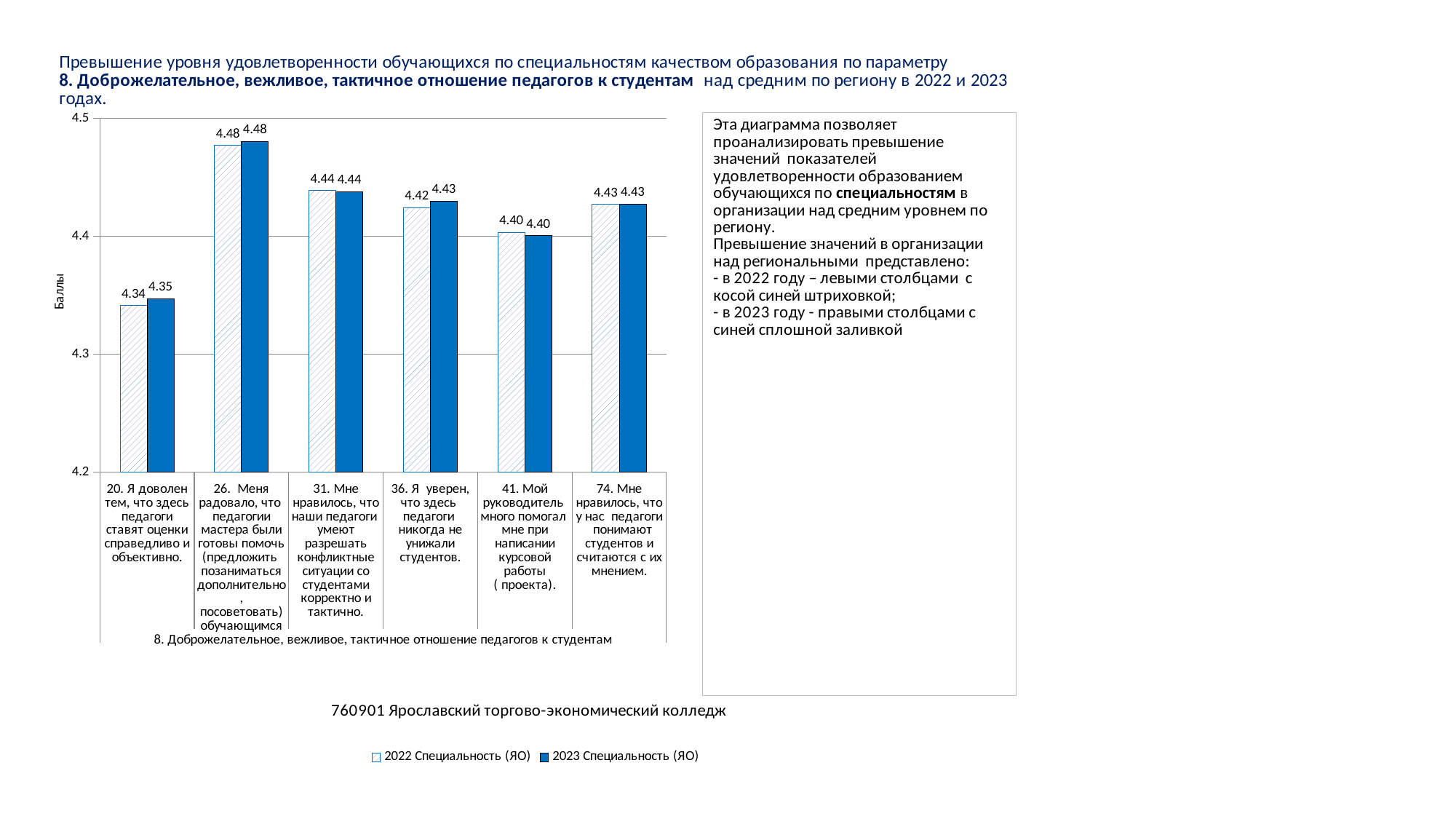
What is the difference between the 2022 values for item 26 and item 20? 0.14 What is the title of the vertical axis of the chart? Баллы How many items (categories) are shown on the x axis of the chart? 6 What is the 2023 Специальность (ЯО) value for item 41 (Мой руководитель много помогал мне при написании курсовой работы)? 4.40 How many series does the legend list? 2 Which is larger: the 2023 value for item 31 or the 2023 value for item 41? Item 31 What is the 2022 Специальность (ЯО) value for item 20 (Я доволен тем, что здесь педагоги ставят оценки справедливо и объективно)? 4.34 What is the 2023 Специальность (ЯО) value for item 36 (Я уверен, что здесь педагоги никогда не унижали студентов)? 4.43 What kind of chart is shown on the slide? Bar chart Is the 2022 value for item 41 greater or less than 4.3? greater Which item has the highest 2023 Специальность (ЯО) value? 26. Меня радовало, что педагоги мастера были готовы помочь Which item has the lowest 2022 Специальность (ЯО) value? 20. Я доволен тем, что здесь педагоги ставят оценки справедливо и объективно